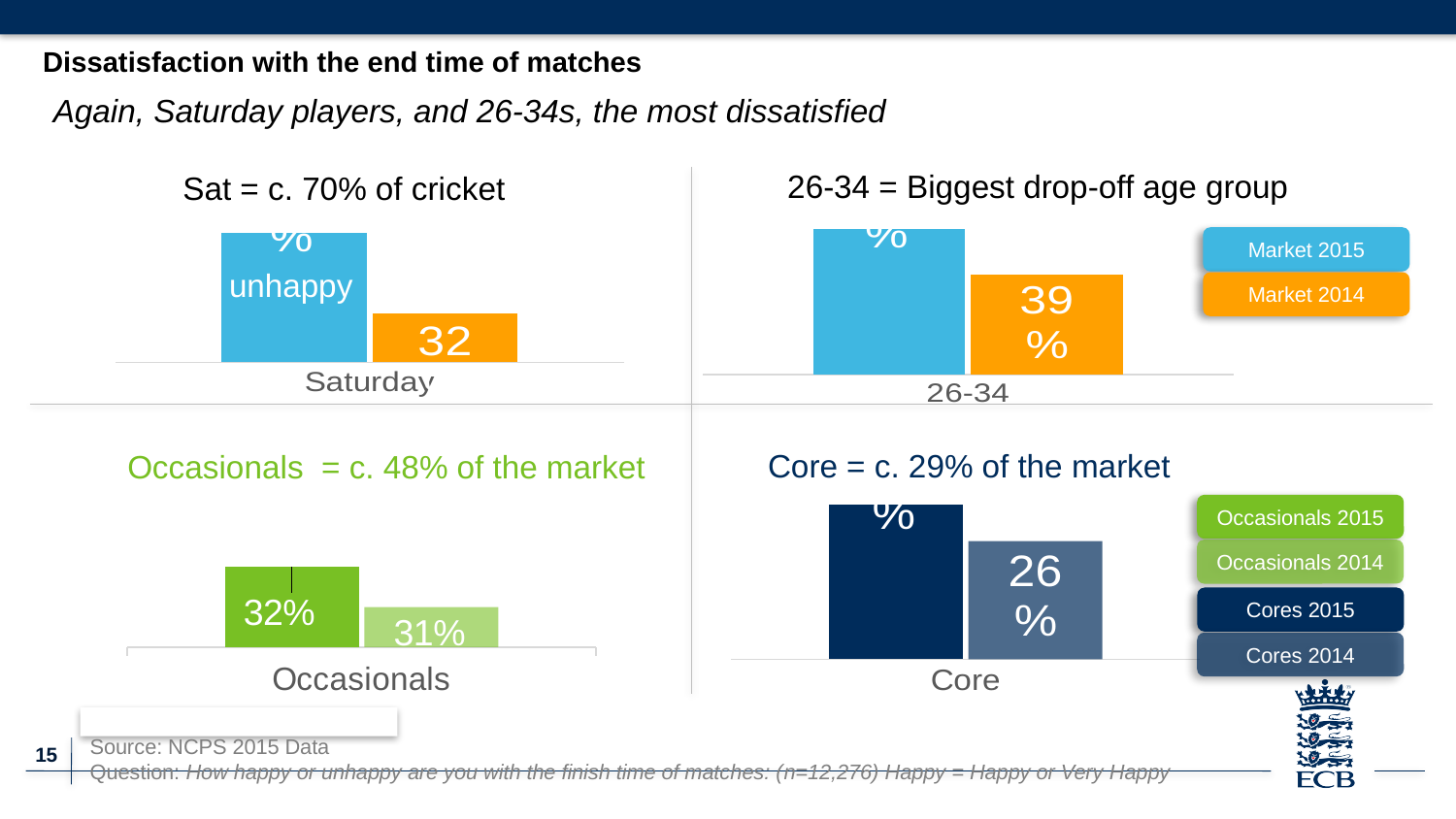
In the 26-34 chart, which bar is taller: Market 2015 or Market 2014? Market 2015 In the Occasionals chart, what is the value for Occasionals 2015? 32% In the 26-34 chart, what is the value for Market 2014? 39% How many series does the legend next to the 26-34 chart list? 2 In the Core chart, which bar is taller: Cores 2015 or Cores 2014? Cores 2015 What colour represents Market 2014 in the legend next to the 26-34 chart? Orange In the Occasionals chart, which is larger: the Occasionals 2015 value or the Occasionals 2014 value? Occasionals 2015 In the Occasionals chart, what is the value for Occasionals 2014? 31% How many entries does the legend next to the Core chart list? 4 In the Occasionals chart, what is the difference between the Occasionals 2015 and Occasionals 2014 values? 1 percentage point What kind of chart is used on this slide to show dissatisfaction with the end time of matches? Bar chart In the Core chart, what is the value for Cores 2014? 26%